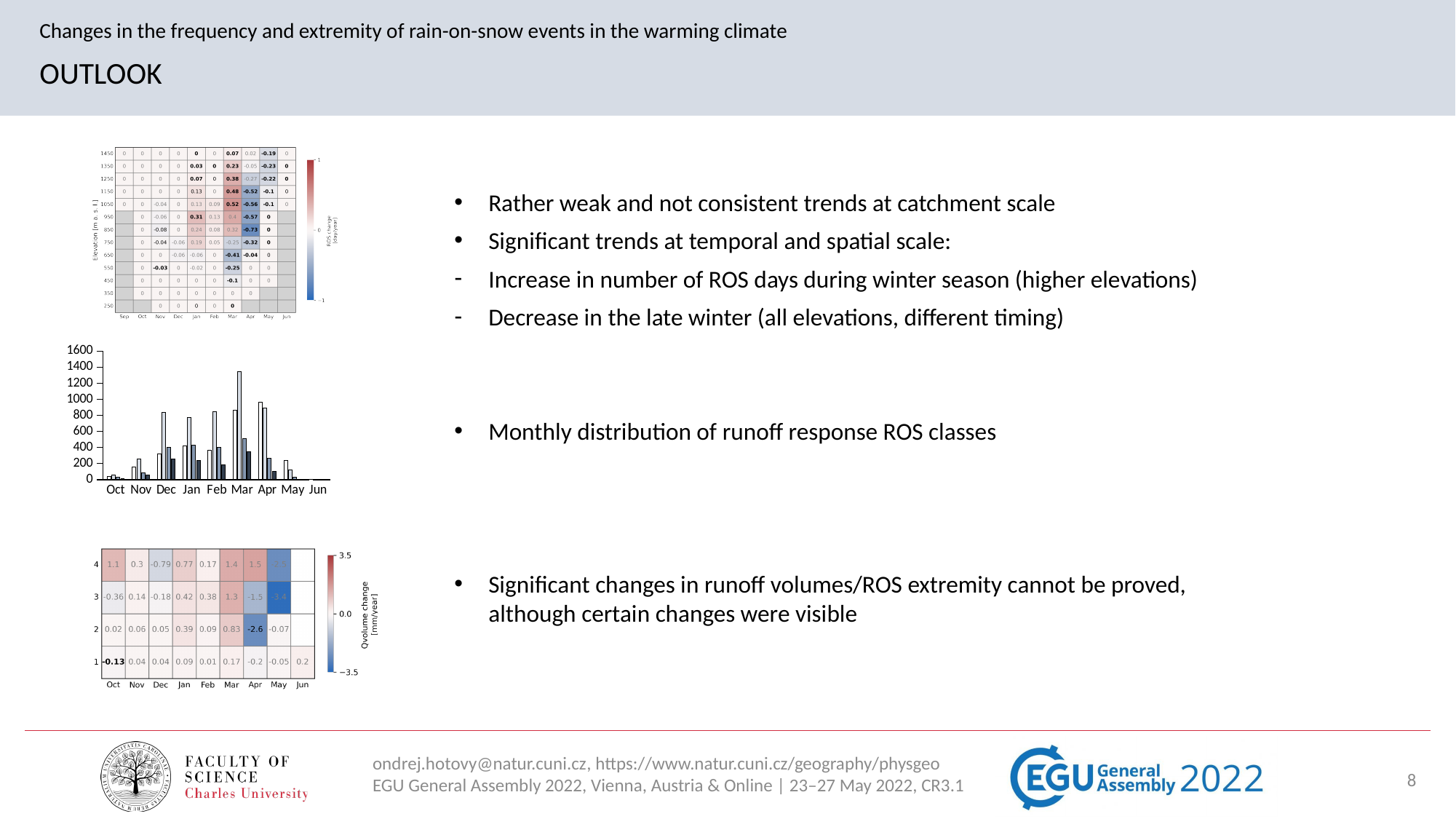
In the middle bar chart, which month has the tallest bar? Mar In the middle bar chart, is the tallest bar for Apr greater or less than 800? greater In the bottom heatmap, what is the value for class 2 in Apr? -2.6 In the middle bar chart, is the tallest bar for Jan greater or less than 600? greater What kind of chart is the middle chart on the left side of the slide? bar chart In the bottom heatmap, what is the value for class 4 in Oct? 1.1 In the middle bar chart, is the tallest bar for Mar greater or less than 1200? greater In the middle bar chart, how many months are labelled on the x axis? 9 In the middle bar chart, which month has the lowest bars? Jun In the bottom heatmap, what is the value for class 3 in May? -3.4 In the middle bar chart, what is the highest value shown on the y axis? 1600